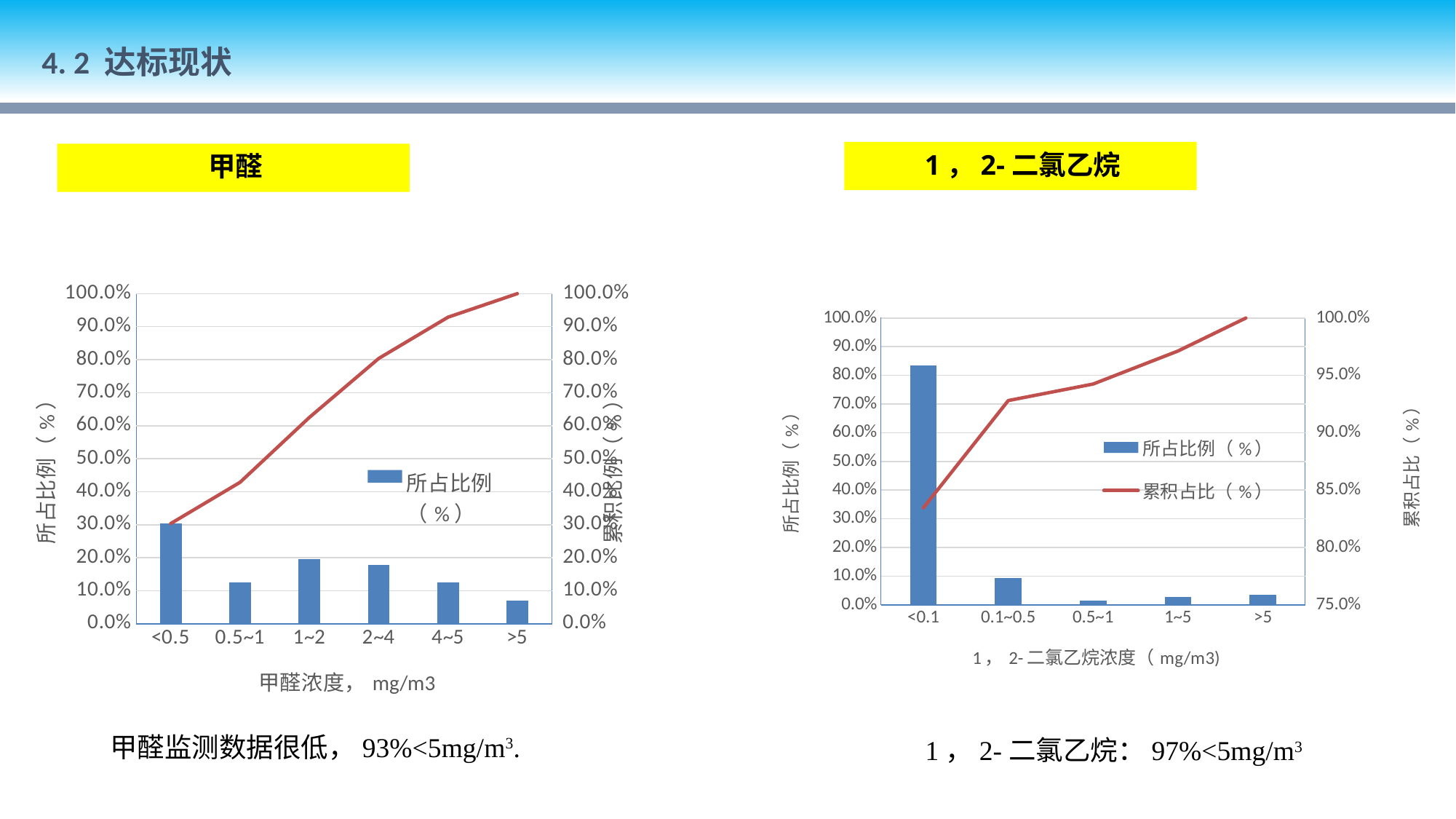
In the 1，2-二氯乙烷 chart on the right, which concentration category has the highest 所占比例 bar? <0.1 In the 甲醛 chart on the left, is the 所占比例 value for <0.5 greater or less than 20.0%? greater In the 甲醛 chart on the left, is the 所占比例 value for >5 greater or less than 10.0%? less In the 1，2-二氯乙烷 chart on the right, how many concentration categories are shown on the x axis? 5 In the 1，2-二氯乙烷 chart on the right, is the 所占比例 value for <0.1 greater or less than 80.0%? greater In the 甲醛 chart on the left, what is the 累积比例 value at the >5 category? 100.0% What kind of chart is the 甲醛 chart on the left? combined bar and line chart In the 1，2-二氯乙烷 chart on the right, how many series does the legend list? 2 In the 甲醛 chart on the left, which concentration category has the lowest 所占比例 bar? >5 In the 1，2-二氯乙烷 chart on the right, does the 累积占比 line rise or fall from <0.1 to >5? rise In the 甲醛 chart on the left, how many concentration categories are shown on the x axis? 6 In the 甲醛 chart on the left, which concentration category has the highest 所占比例 bar? <0.5